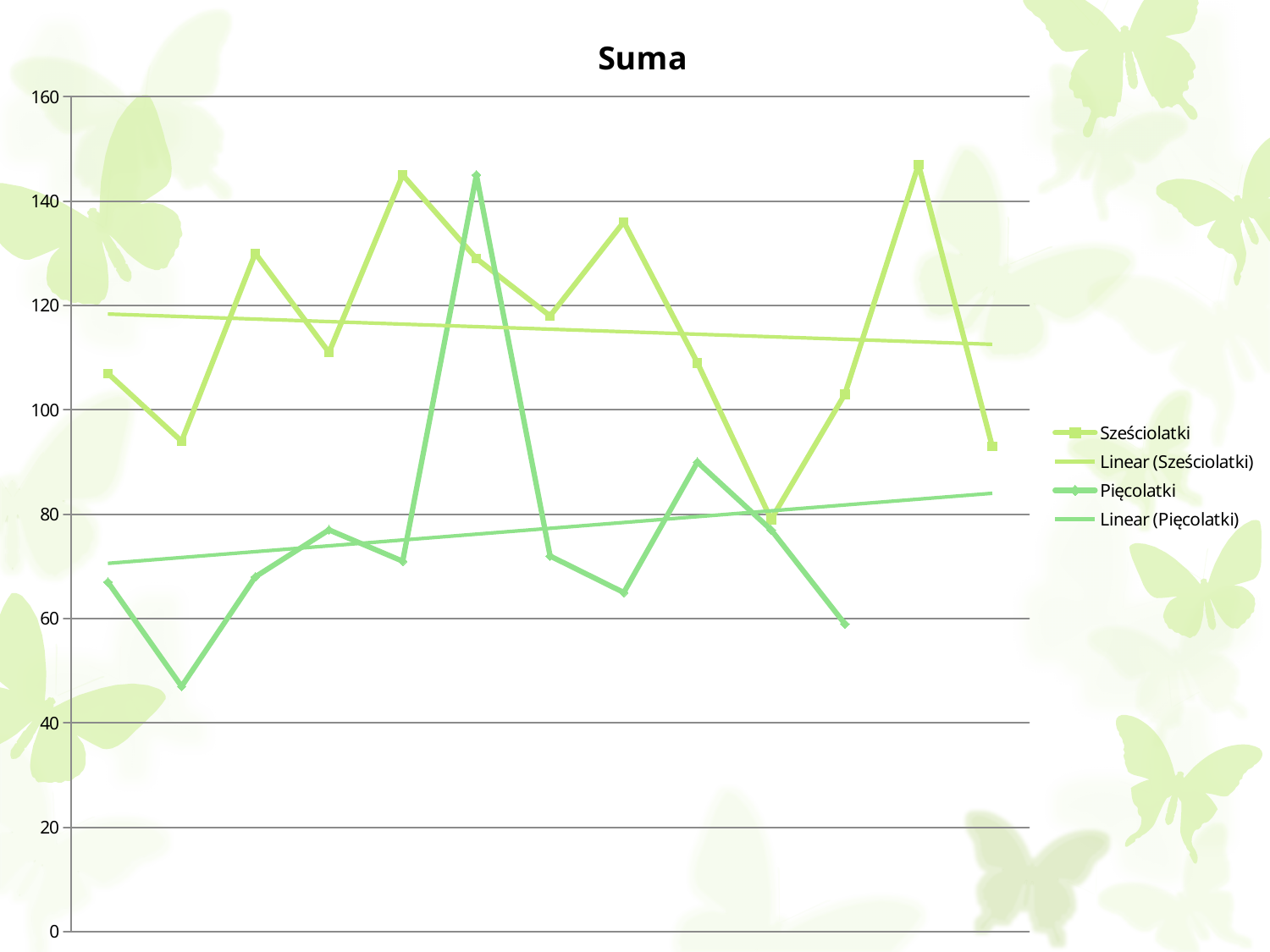
Does the Linear (Pięcolatki) trendline rise or fall from left to right? rise How many data points does the Pięcolatki series have? 11 Is the first point of the Sześciolatki series greater or less than 100? greater How many data points does the Sześciolatki series have? 13 At the first point, which series has the larger value, Sześciolatki or Pięcolatki? Sześciolatki Is the second point of the Pięcolatki series greater or less than 60? less Does the Linear (Sześciolatki) trendline rise or fall from left to right? fall What is the maximum value shown on the vertical axis? 160 Is the highest point of the Sześciolatki series greater or less than 140? greater What kind of chart is shown on the slide? line chart How many entries does the chart legend list? 4 What is the title of the chart? Suma